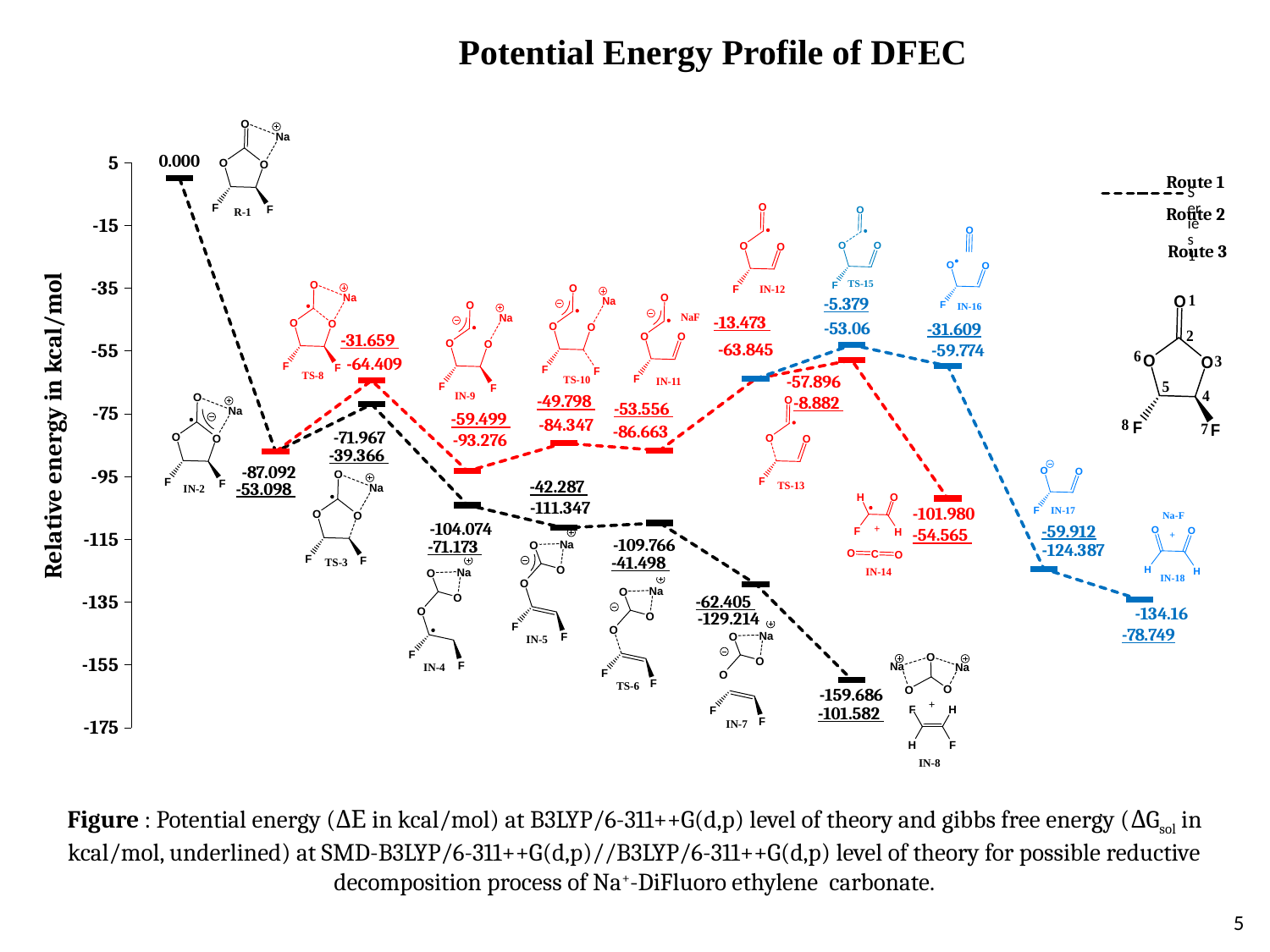
What is the non-underlined value printed for IN-2? -87.092 What is the underlined value printed for IN-8? -101.582 Is the plotted energy of IN-8 greater or less than -155? less What is the y-axis title of the chart? Relative energy in kcal/mol What is the non-underlined value printed for IN-8? -159.686 Which is lower in plotted energy, IN-4 or TS-3? IN-4 What is the non-underlined value printed for IN-18? -134.16 Which labeled structure has the lowest plotted energy on the profile? IN-8 What is the title of the chart? Potential Energy Profile of DFEC What is the underlined value printed for TS-15? -5.379 What value is printed for the starting structure R-1? 0.000 How many routes does the legend list? 3